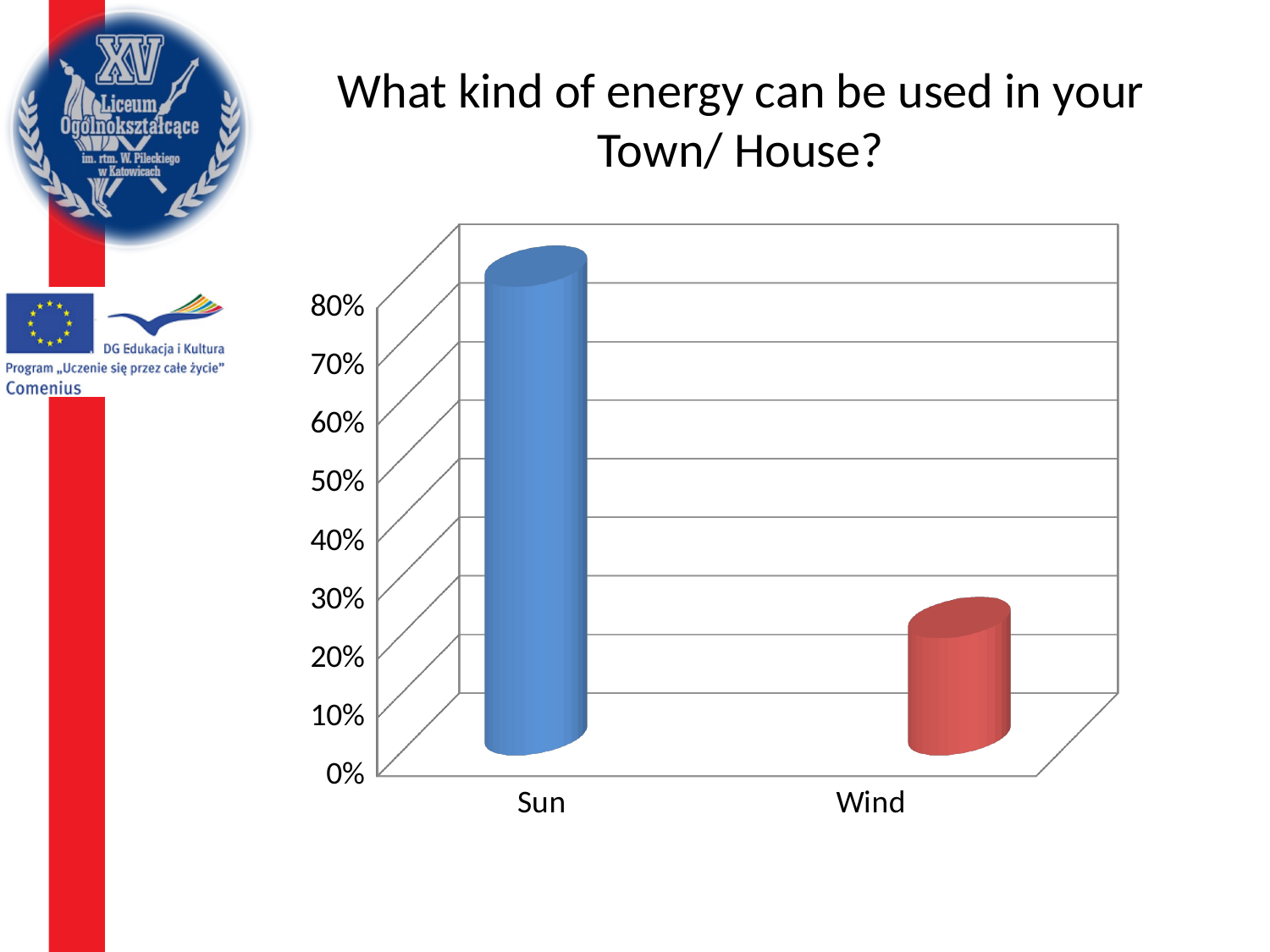
What colour is the bar for Wind? red Is the value for Sun greater or less than 50%? greater Which category has the highest value in the chart? Sun Is the value for Wind greater or less than 50%? less Which category has the lowest value in the chart? Wind How many categories are shown on the x axis of the chart? 2 Is the value for Wind greater or less than 40%? less What type of chart is shown on the slide? bar chart What is the title of the chart? What kind of energy can be used in your Town/ House? Which is larger, the value for Sun or the value for Wind? Sun